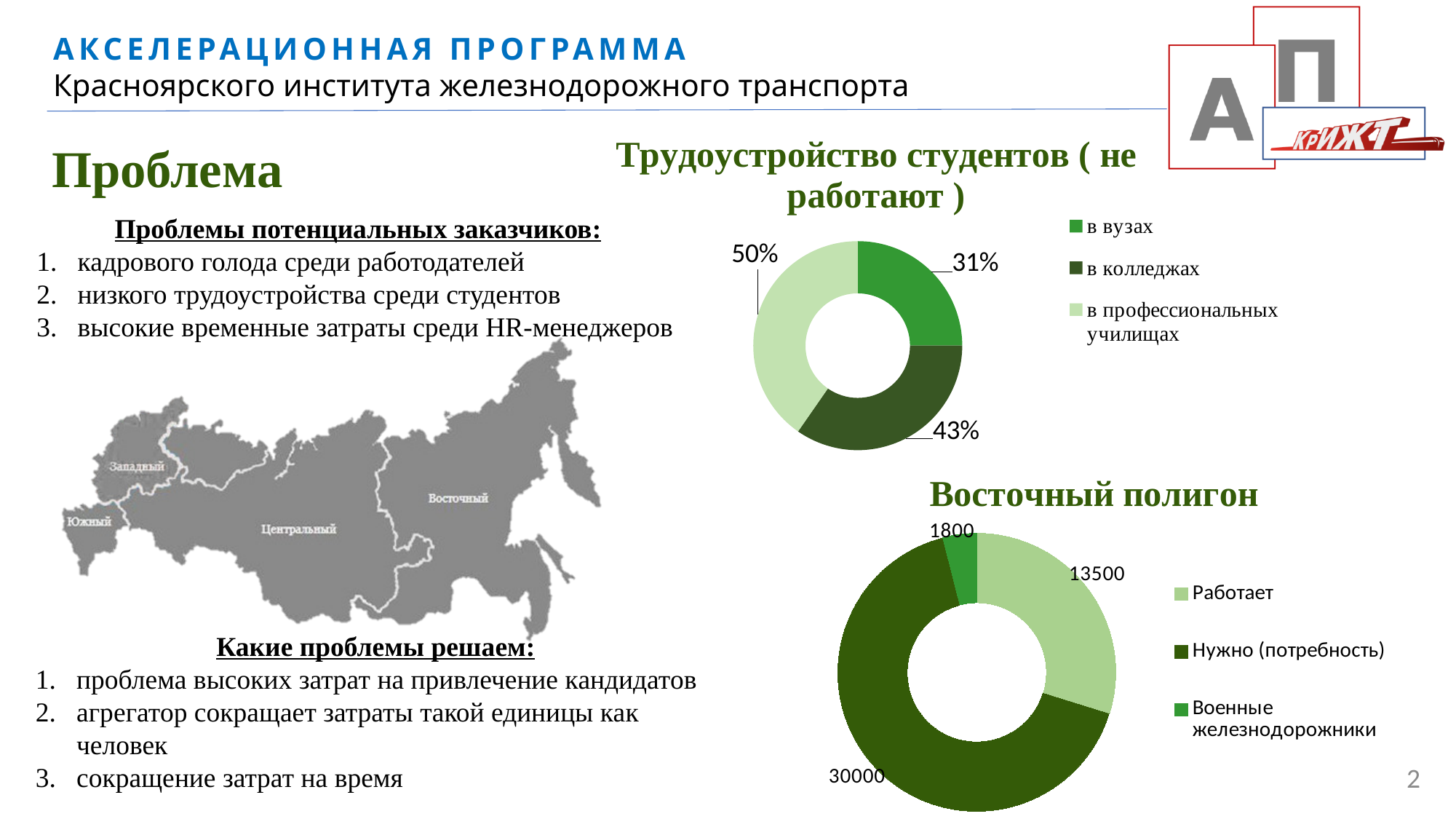
In the "Трудоустройство студентов ( не работают )" chart, what is the value for "в колледжах"? 43% In the "Восточный полигон" chart, which category has the largest value? Нужно (потребность) In the "Восточный полигон" chart, which is larger: "Работает" or "Военные железнодорожники"? Работает In the "Восточный полигон" chart, what is the value for "Нужно (потребность)"? 30000 What kind of chart is the "Трудоустройство студентов ( не работают )" chart? Doughnut chart How many categories does the legend of the "Трудоустройство студентов ( не работают )" chart list? 3 In the "Трудоустройство студентов ( не работают )" chart, which category has the highest value? в профессиональных училищах In the "Трудоустройство студентов ( не работают )" chart, what is the difference between the values for "в профессиональных училищах" and "в вузах"? 19% In the "Трудоустройство студентов ( не работают )" chart, what is the value for "в вузах"? 31% In the "Трудоустройство студентов ( не работают )" chart, which category has the lowest value? в вузах In the "Восточный полигон" chart, what is the value for "Военные железнодорожники"? 1800 In the "Восточный полигон" chart, what is the difference between "Нужно (потребность)" and "Работает"? 16500